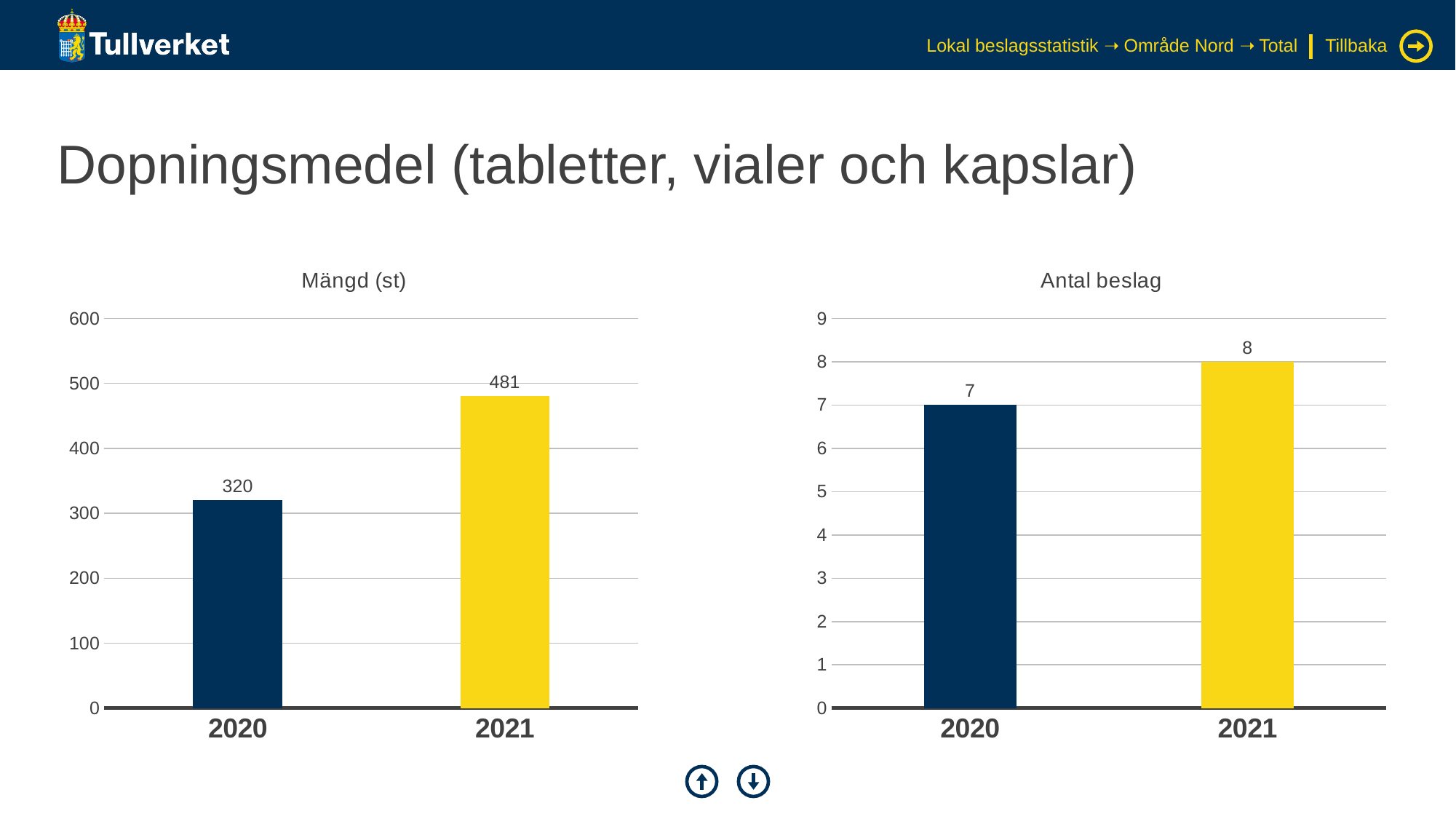
What kind of chart is the "Mängd (st)" chart? bar chart In the "Antal beslag" chart, what is the difference between the 2021 and 2020 values? 1 In the "Mängd (st)" chart, what is the difference between the 2021 and 2020 values? 161 In the "Mängd (st)" chart, what is the value for 2020? 320 In the "Antal beslag" chart, do the values rise or fall from 2020 to 2021? rise In the "Mängd (st)" chart, is the value for 2020 greater or less than 400? less In the "Mängd (st)" chart, which year has the highest value? 2021 In the "Antal beslag" chart, what is the value for 2020? 7 How many years are shown on the x axis of the "Antal beslag" chart? 2 In the "Mängd (st)" chart, what is the value for 2021? 481 In the "Antal beslag" chart, what is the value for 2021? 8 In the "Antal beslag" chart, which year has the lowest value? 2020